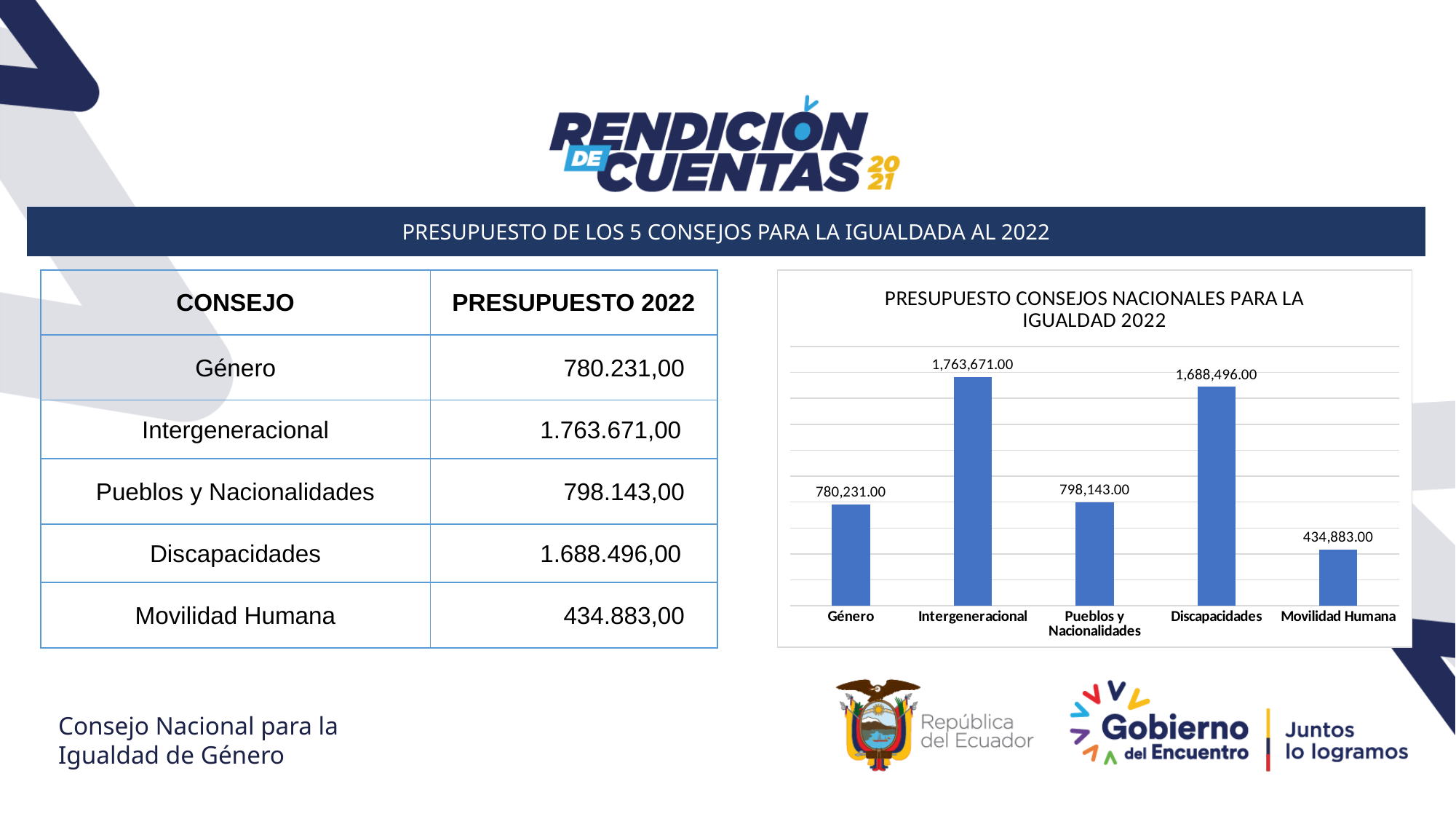
What is the value for Género in the chart? 780,231.00 What is the value for Intergeneracional in the chart? 1,763,671.00 Which category has the lowest value in the chart? Movilidad Humana What is the title of the chart? PRESUPUESTO CONSEJOS NACIONALES PARA LA IGUALDAD 2022 What is the value for Pueblos y Nacionalidades in the chart? 798,143.00 Which category has the highest value in the chart? Intergeneracional What is the difference between the values for Intergeneracional and Discapacidades? 75,175.00 What is the value for Movilidad Humana in the chart? 434,883.00 Which is larger, the value for Discapacidades or the value for Intergeneracional? Intergeneracional What is the difference between the values for Pueblos y Nacionalidades and Género? 17,912.00 How many categories are shown in the chart? 5 What kind of chart is shown on the slide? Bar chart